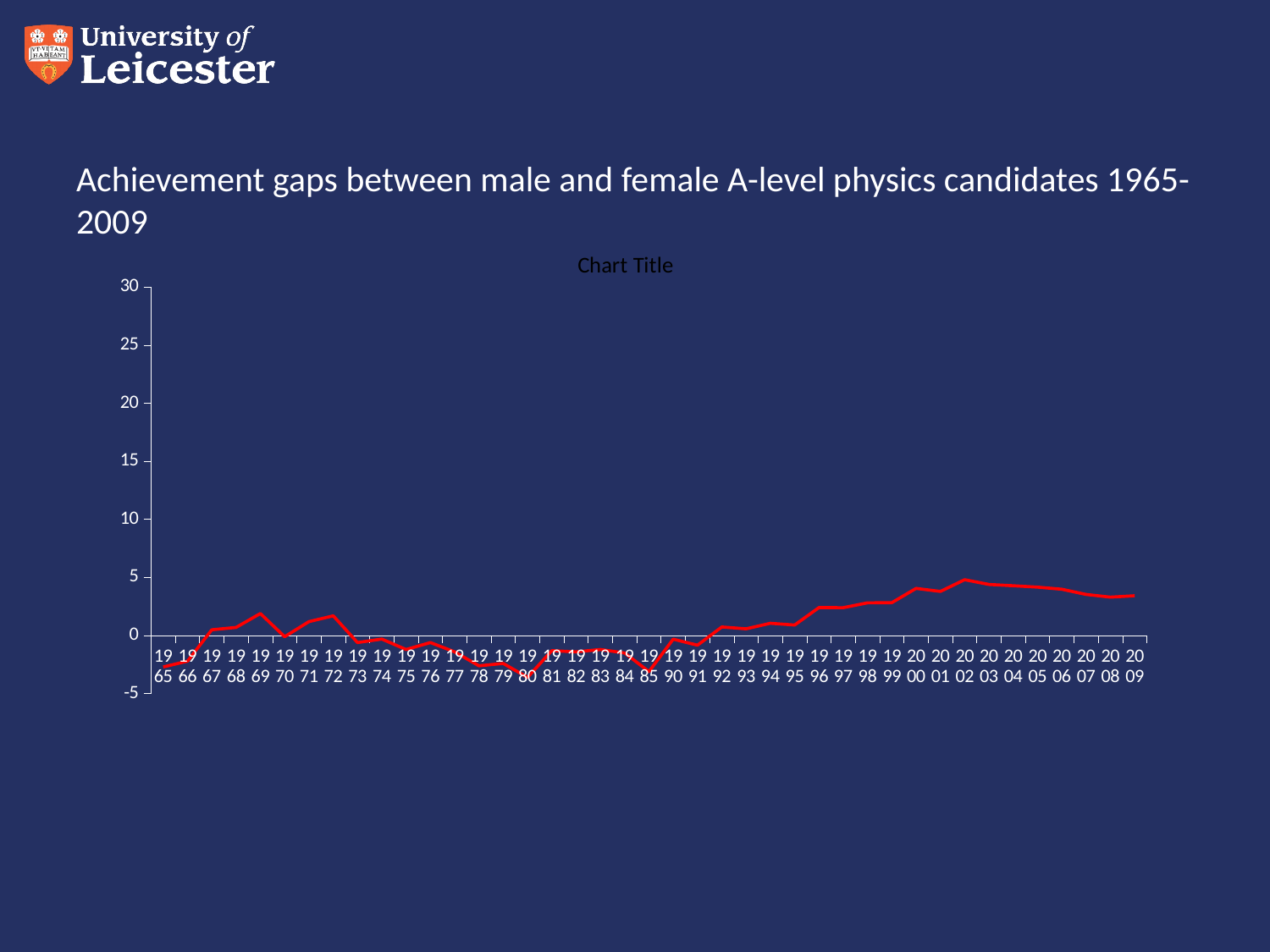
What kind of chart is shown on the slide? line chart Do the values generally rise or fall between 1990 and 2002? rise Is the value for 1980 greater or less than 0? less What colour is the plotted line? red Is the value for 2009 greater or less than 5? less Is the value for 2002 greater or less than 0? greater Which is larger, the value for 2002 or the value for 1965? 2002 How many data points (years) are plotted along the x axis? 41 What is the title printed above the chart's plot area? Chart Title Which year has the highest value on the line? 2002